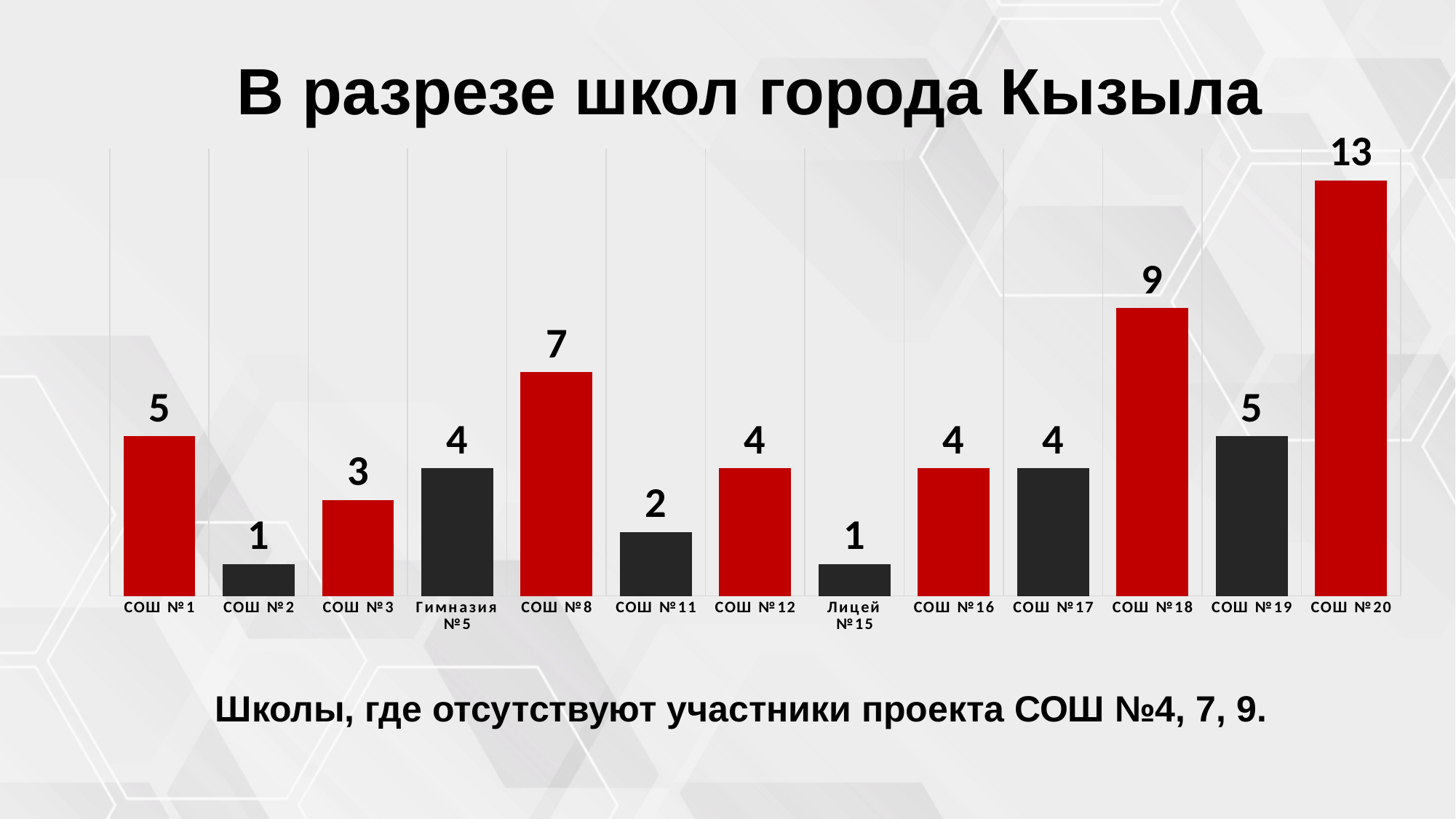
What is the value for СОШ №18? 9 What is the value for Лицей №15? 1 Which is larger, the value for СОШ №8 or the value for СОШ №19? СОШ №8 What is the difference between the values for СОШ №20 and СОШ №18? 4 What is the value for СОШ №20? 13 What is the difference between the values for СОШ №1 and СОШ №2? 4 What kind of chart is shown on the slide? bar chart Which school has the highest value? СОШ №20 What is the title of the slide? В разрезе школ города Кызыла What is the value for Гимназия №5? 4 What colour is the bar for СОШ №17? black How many schools are shown on the chart? 13